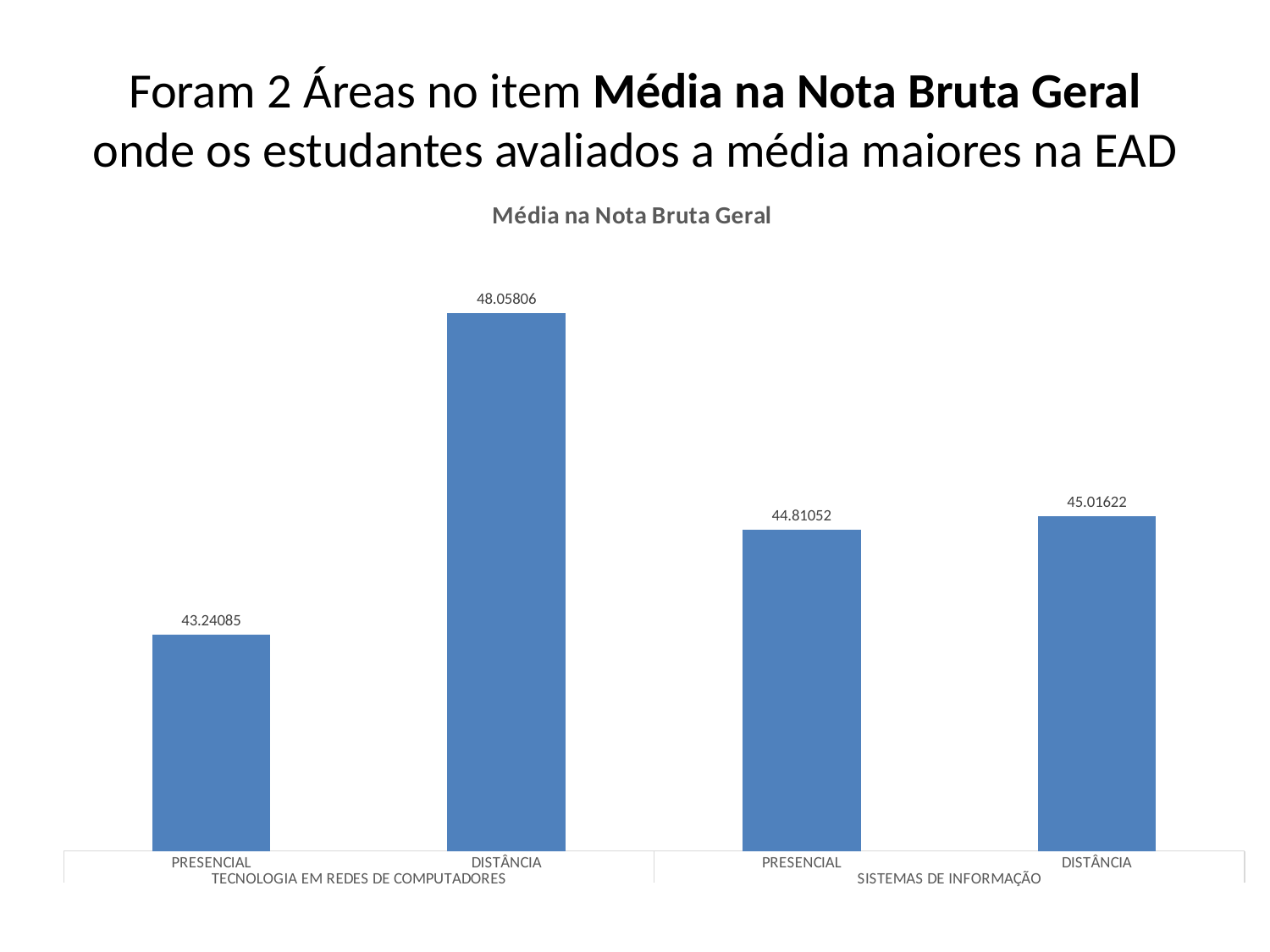
What is the difference between DISTÂNCIA and PRESENCIAL in TECNOLOGIA EM REDES DE COMPUTADORES? 4.81721 What kind of chart is shown on the slide? Bar chart What is the value for DISTÂNCIA in TECNOLOGIA EM REDES DE COMPUTADORES? 48.05806 In SISTEMAS DE INFORMAÇÃO, which is larger: PRESENCIAL or DISTÂNCIA? DISTÂNCIA Which bar has the highest value in the chart? DISTÂNCIA (TECNOLOGIA EM REDES DE COMPUTADORES) Which bar has the lowest value in the chart? PRESENCIAL (TECNOLOGIA EM REDES DE COMPUTADORES) What is the value for PRESENCIAL in TECNOLOGIA EM REDES DE COMPUTADORES? 43.24085 What is the value for DISTÂNCIA in SISTEMAS DE INFORMAÇÃO? 45.01622 What is the difference between DISTÂNCIA and PRESENCIAL in SISTEMAS DE INFORMAÇÃO? 0.20570 What is the title of the chart? Média na Nota Bruta Geral How many bars are plotted in the chart? 4 What is the value for PRESENCIAL in SISTEMAS DE INFORMAÇÃO? 44.81052